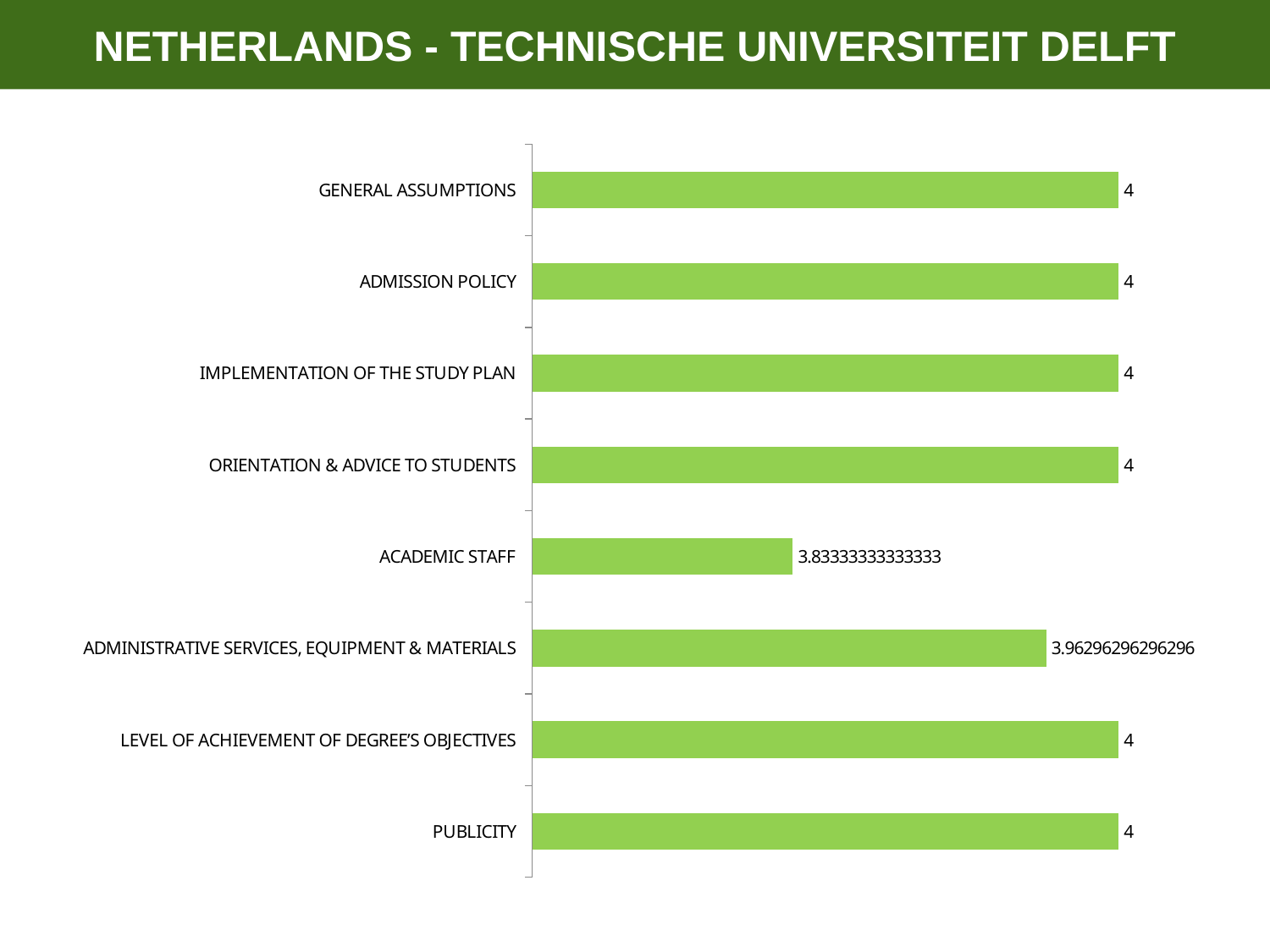
How many categories are shown in the chart? 8 What is the title of the slide? NETHERLANDS - TECHNISCHE UNIVERSITEIT DELFT What is the value for ADMINISTRATIVE SERVICES, EQUIPMENT & MATERIALS? 3.96296296296296 What is the value for ADMISSION POLICY? 4 Which is larger, the value for ACADEMIC STAFF or the value for ADMINISTRATIVE SERVICES, EQUIPMENT & MATERIALS? ADMINISTRATIVE SERVICES, EQUIPMENT & MATERIALS Which category has the lowest value? ACADEMIC STAFF What is the value for ACADEMIC STAFF? 3.83333333333333 What kind of chart is shown on the slide? Bar chart How many categories have a value of 4? 6 What is the value for PUBLICITY? 4 What colour are the bars in the chart? Green Which is larger, the value for GENERAL ASSUMPTIONS or the value for ACADEMIC STAFF? GENERAL ASSUMPTIONS